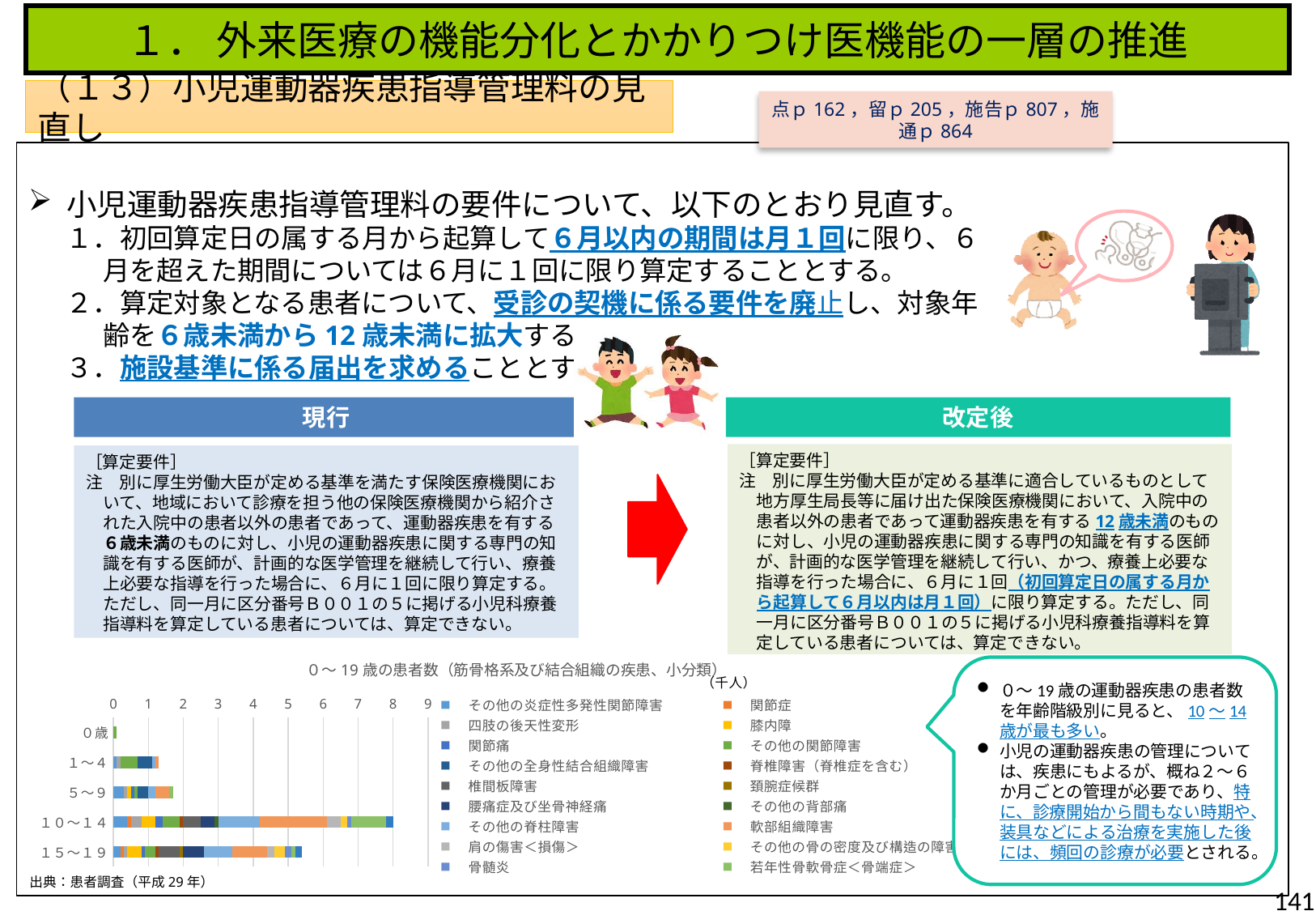
In the 0～19歳の患者数 chart, is the total for 1～4 greater or less than 2? less In the 0～19歳の患者数 chart, which age group has a larger total, 15～19 or 5～9? 15～19 In the 0～19歳の患者数 chart, is the total for 15～19 greater or less than 4? greater How many series does the legend of the 0～19歳の患者数 chart list? 18 What kind of chart is shown at the bottom left of the slide? Stacked horizontal bar chart What unit is shown for the values in the 0～19歳の患者数 chart? 千人 In the 0～19歳の患者数 chart, which age group has a larger total, 10～14 or 15～19? 10～14 How many age categories are plotted in the chart titled 0～19歳の患者数（筋骨格系及び結合組織の疾患、小分類）? 5 In the 0～19歳の患者数 chart, which age group has the shortest bar? 0歳 In the 0～19歳の患者数 chart, which age group has the longest bar? 10～14 In the 0～19歳の患者数 chart, is the total for 10～14 greater or less than 7? greater What source is cited below the 0～19歳の患者数 chart? 患者調査（平成29年）